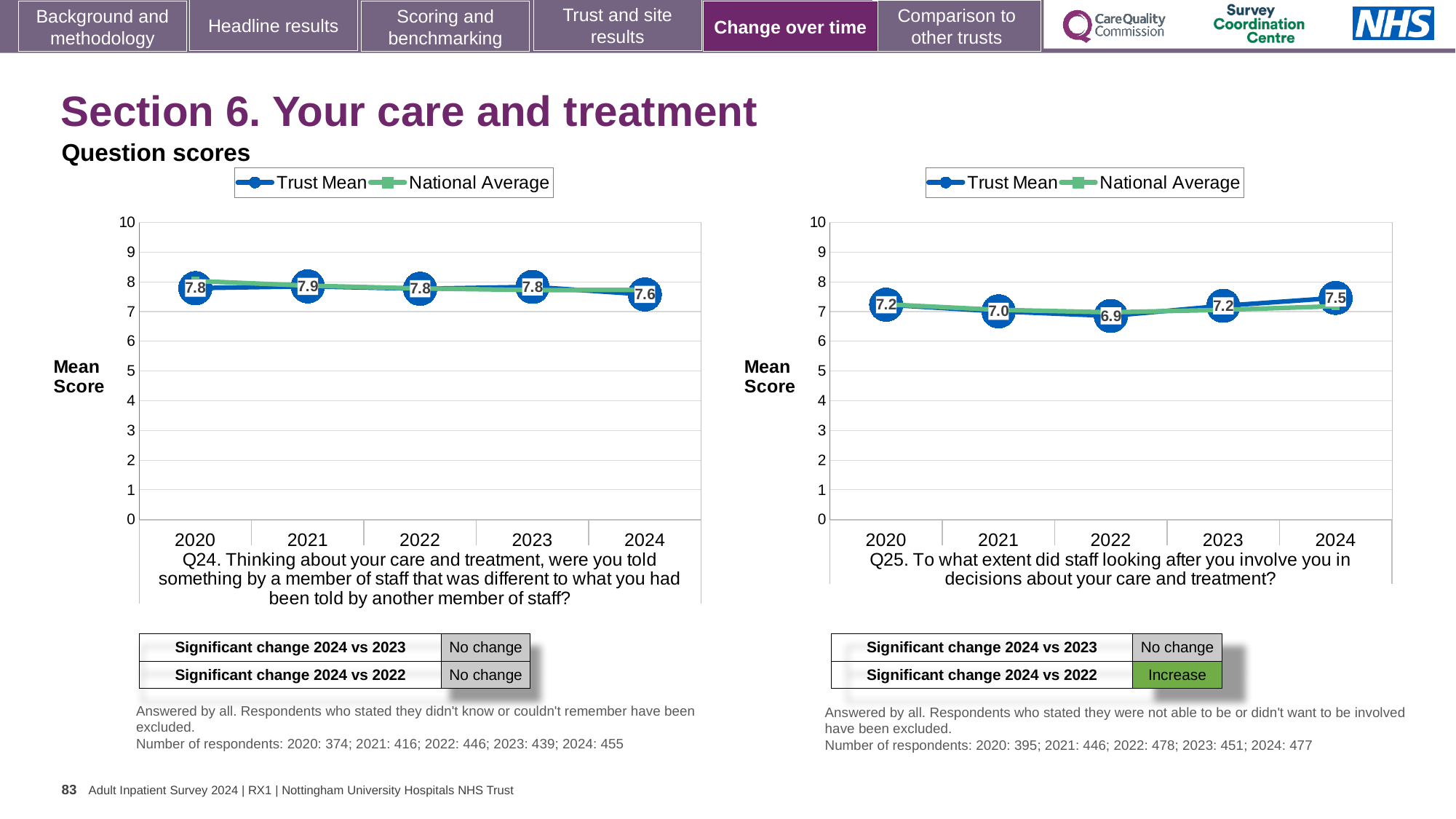
On the Q25 chart (right), which year has the highest Trust Mean score? 2024 On the Q24 chart (left), what is the Trust Mean score for 2024? 7.6 On the Q25 chart (right), what is the difference between the Trust Mean scores for 2024 and 2022? 0.6 On the Q25 chart (right), what is the Trust Mean score for 2022? 6.9 On the Q25 chart (right), which year has the lowest Trust Mean score? 2022 On the Q24 chart (left), is the Trust Mean score for 2021 or 2024 higher? 2021 On the Q24 chart (left), how many series does the legend list? 2 On the Q24 chart (left), which year has the lowest Trust Mean score? 2024 On the Q24 chart (left), what is the Trust Mean score for 2021? 7.9 What type of chart is used for the Q25 chart (right)? Line chart On the Q25 chart (right), how many years are plotted on the x axis? 5 On the Q25 chart (right), what is the Trust Mean score for 2024? 7.5